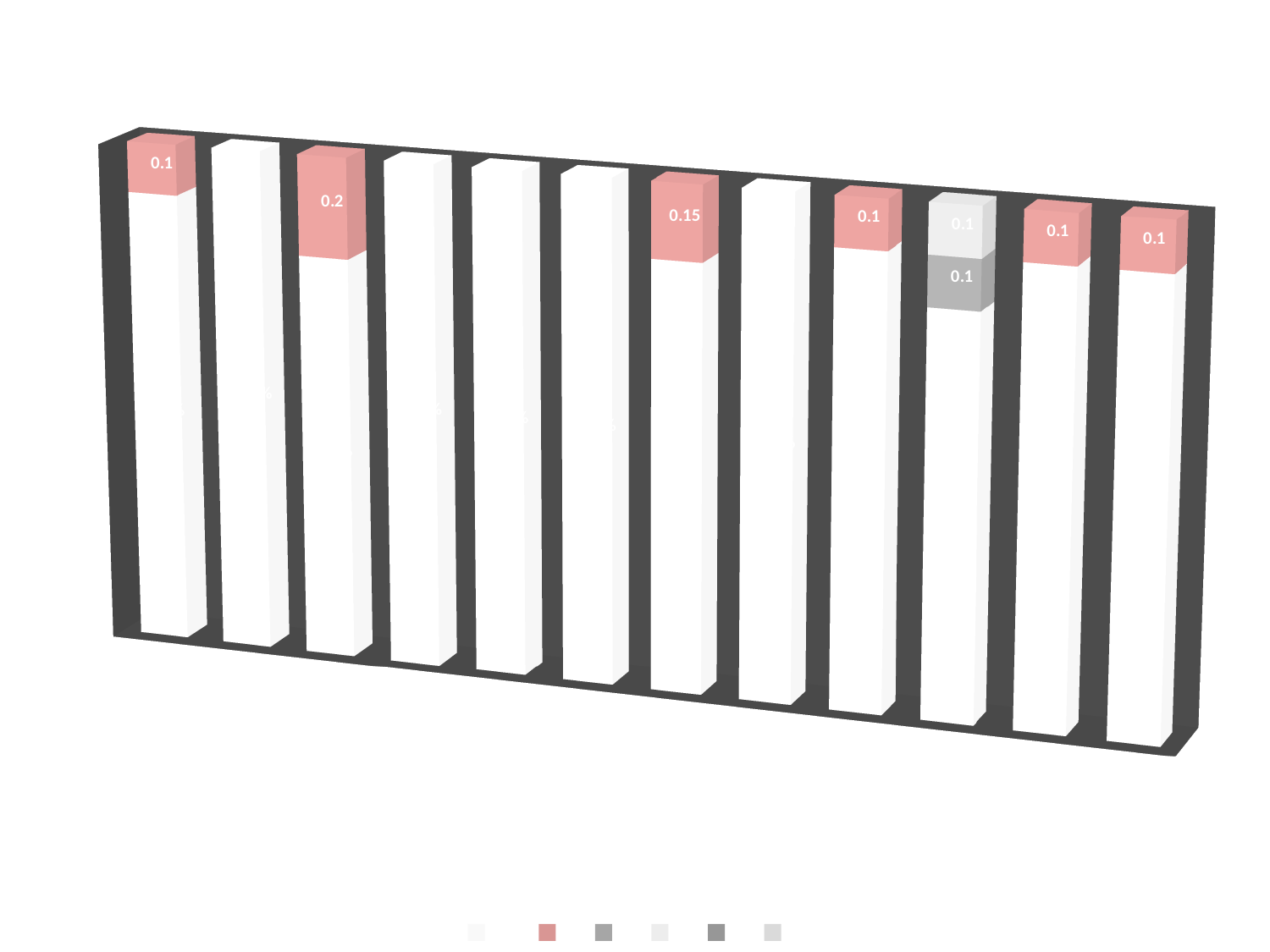
How many bars are plotted in the chart? 12 How many series does the legend list? 6 What is the difference between the pink segment on the third bar from the left and the pink segment on the seventh bar from the left? 0.05 What is the value of the dark grey segment on the tenth bar from the left? 0.1 What is the value of the pink segment on the leftmost bar? 0.1 What is the value of the pink segment on the third bar from the left? 0.2 Which bar has the largest pink segment? the third bar from the left What kind of chart is shown on the slide? bar chart What colour is the top segment of the third bar from the left? pink How many bars have a pink segment at the top? 6 Which is larger: the pink segment on the third bar from the left or the pink segment on the seventh bar from the left? the third bar from the left What is the value of the pink segment on the seventh bar from the left? 0.15